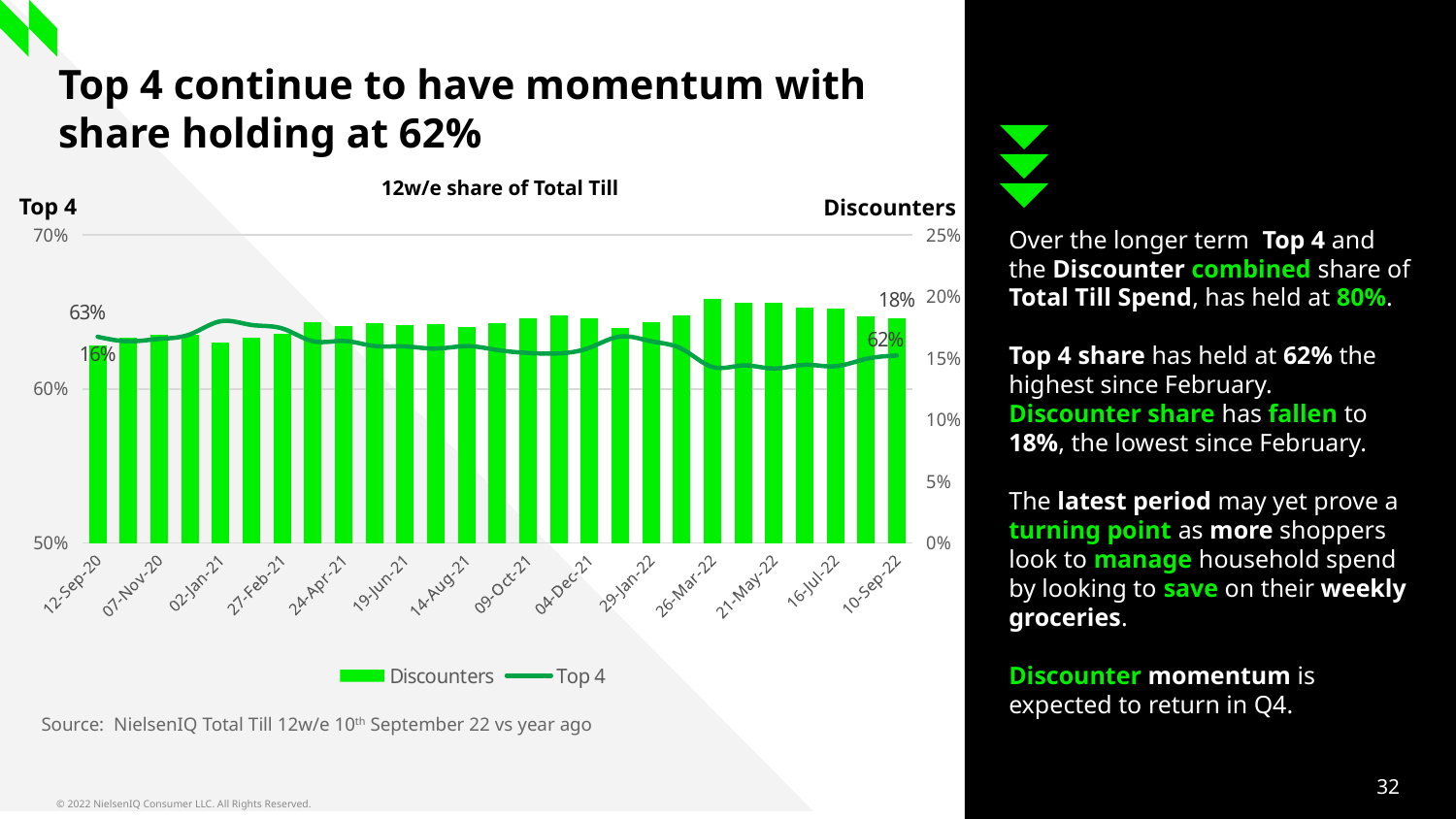
Which is larger, the Top 4 share at 12-Sep-20 or at 10-Sep-22? 12-Sep-20 Is the Discounters share at 26-Mar-22 greater or less than 15%? greater What is the title of the chart? 12w/e share of Total Till By how much did the Discounters share change between 12-Sep-20 and 10-Sep-22? 2% What kind of chart is shown on the slide? Combined bar and line chart Does the Discounters share rise or fall overall from 12-Sep-20 to 10-Sep-22? Rise What is the Top 4 share of Total Till at 12-Sep-20? 63% What is the Discounters share of Total Till at 12-Sep-20? 16% What is the Discounters share of Total Till at 10-Sep-22? 18% How many series does the chart legend list? 2 What is the Top 4 share of Total Till at 10-Sep-22? 62% What is the difference between the Top 4 share at 12-Sep-20 and at 10-Sep-22? 1%